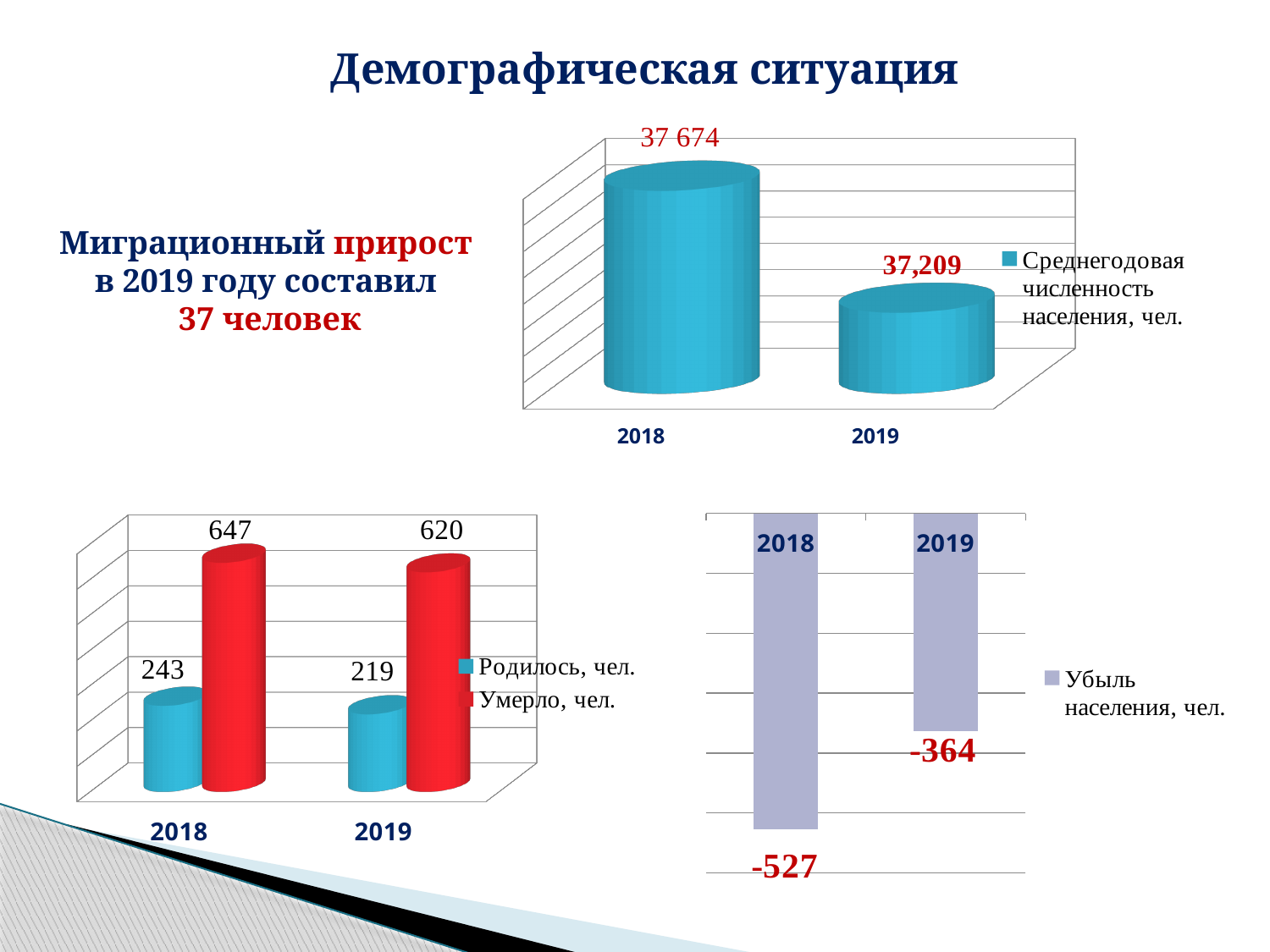
In the top-right chart, what is the average annual population (Среднегодовая численность населения) for 2018? 37 674 What kind of chart is the bottom-right chart? Bar chart In the bottom-left chart, which is larger in 2019: births or deaths? Deaths (Умерло) In the bottom-right chart, what is the population decline for 2019? -364 In the bottom-left chart, how many people were born (Родилось) in 2018? 243 In the top-right chart, what is the average annual population for 2019? 37,209 In the bottom-left chart, how many people died (Умерло) in 2019? 620 In the bottom-right chart, what is the population decline (Убыль населения) for 2018? -527 In the top-right chart, which year has the higher average annual population? 2018 In the bottom-left chart, how many series does the legend list? 2 In the bottom-left chart, what is the difference between deaths and births in 2018? 404 In the bottom-left chart, do the number of births rise or fall from 2018 to 2019? Fall